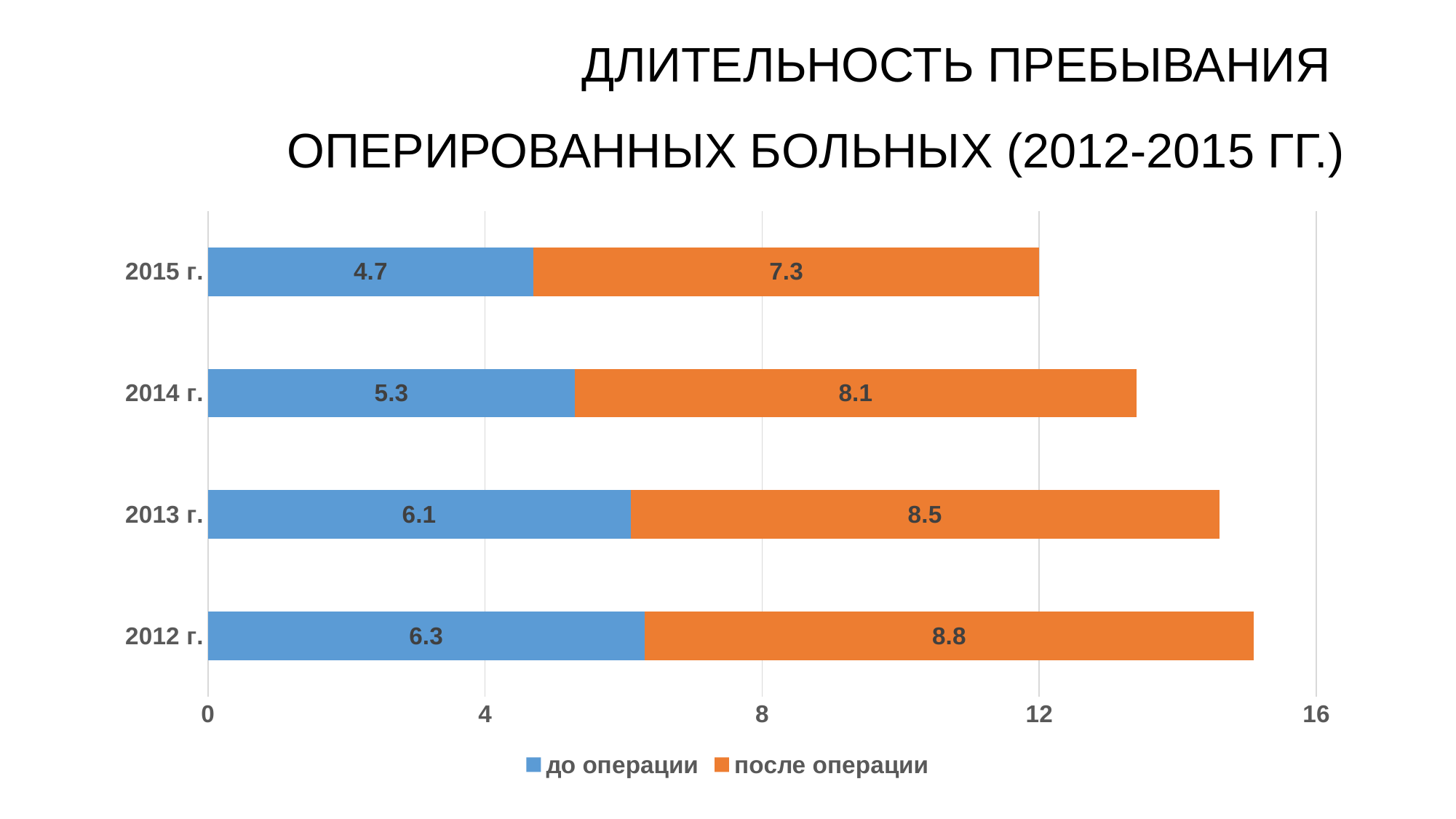
What is the difference between the "после операции" values for 2012 г. and 2015 г.? 1.5 What is the total of the stacked bar for 2014 г.? 13.4 What is the value for "после операции" in 2012 г.? 8.8 Which is larger: the "до операции" value for 2014 г. or for 2013 г.? 2013 г. How many series does the legend list? 2 What is the total of the stacked bar for 2015 г.? 12 What is the value for "до операции" in 2015 г.? 4.7 What kind of chart is shown on the slide? Stacked bar chart Which year has the highest value for "до операции"? 2012 г. What is the value for "после операции" in 2013 г.? 8.5 How many years are shown on the chart? 4 Which year has the lowest value for "после операции"? 2015 г.